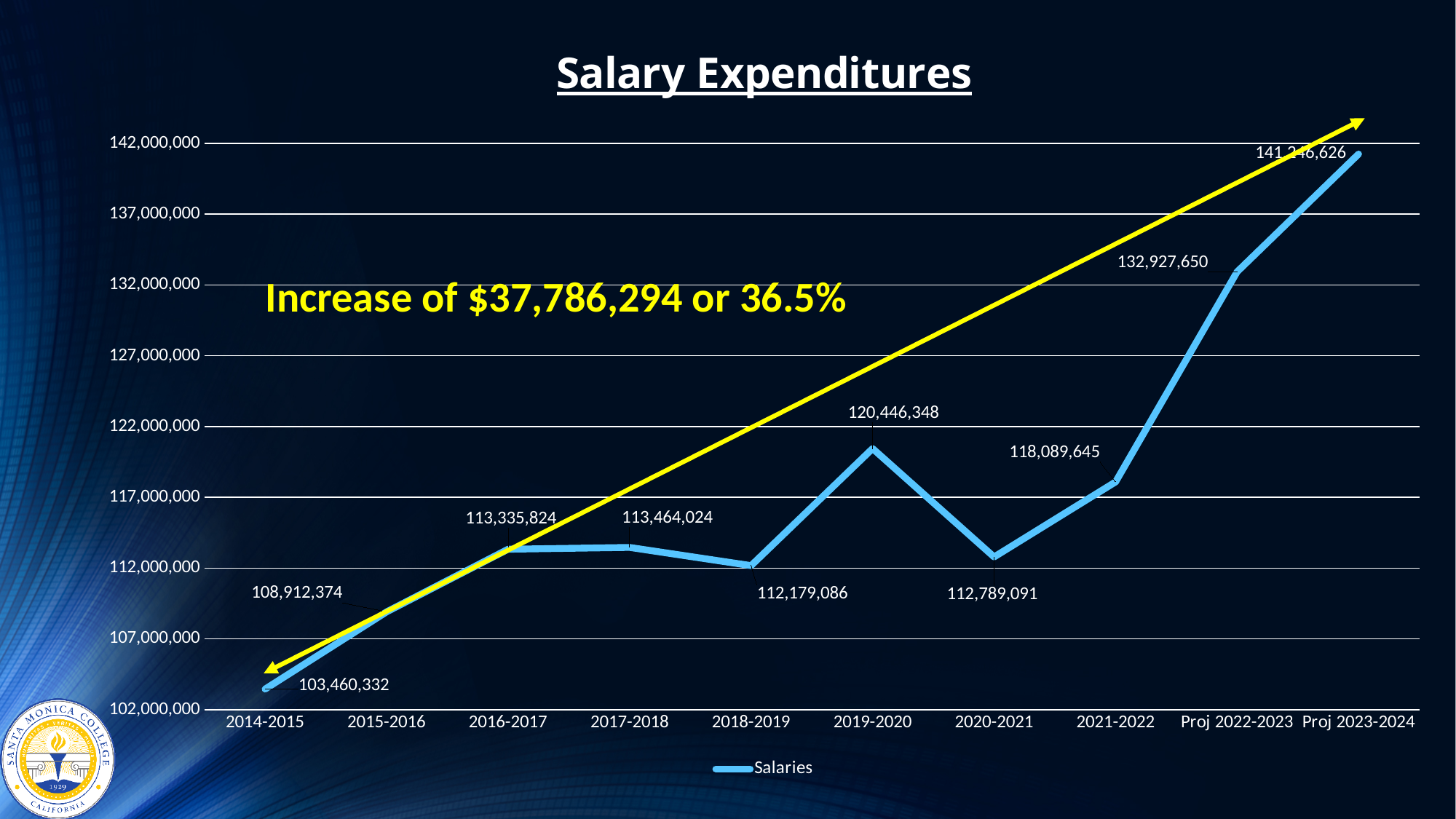
Which year has the highest salary expenditure? Proj 2023-2024 What is the salary expenditure value for Proj 2022-2023? 132,927,650 What type of chart is shown on the slide? line chart Which year has the lowest salary expenditure? 2014-2015 What is the difference between the salary expenditures for 2019-2020 and 2020-2021? 7,657,257 How many years (data points) are plotted on the x axis? 10 What is the salary expenditure value for 2020-2021? 112,789,091 What is the salary expenditure value for 2014-2015? 103,460,332 Which is larger, the salary expenditure for 2018-2019 or for 2021-2022? 2021-2022 What is the salary expenditure value for 2019-2020? 120,446,348 How many series does the legend list? 1 What is the title of the chart? Salary Expenditures